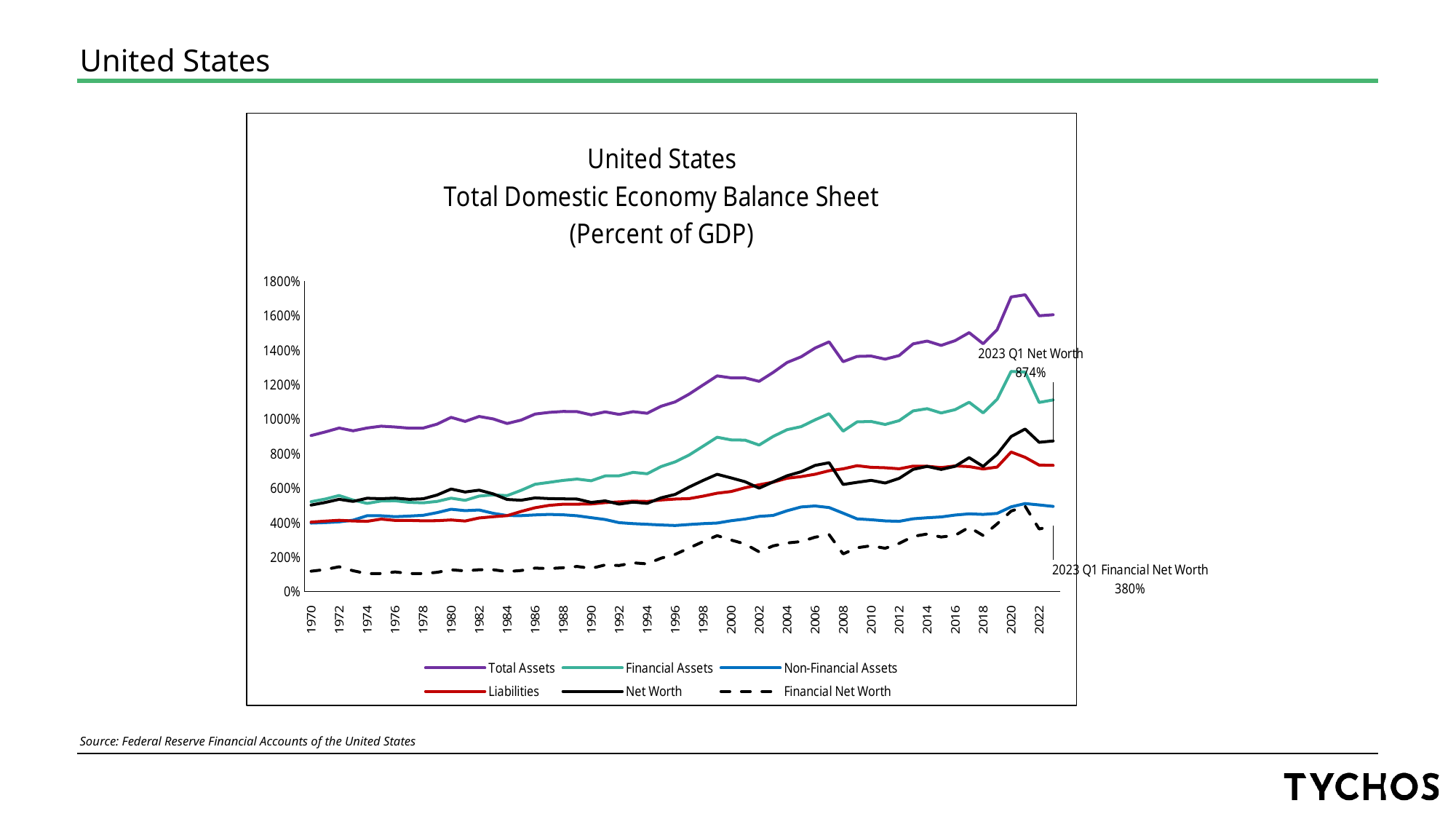
How many series does the legend list? 6 What is the 2023 Q1 Net Worth value labelled on the chart? 874% Is the value for Financial Assets in 1970 greater or less than 800%? less Does the Total Assets series generally rise or fall from 1970 to 2022? rise What kind of chart is shown on the slide? Line chart What is the 2023 Q1 Financial Net Worth value labelled on the chart? 380% What is the difference between the labelled 2023 Q1 Net Worth and 2023 Q1 Financial Net Worth values? 494% In 2022, which is larger: Liabilities or Non-Financial Assets? Liabilities Which series is drawn as a dashed line? Financial Net Worth Which series has the highest values across the whole period? Total Assets Is the value for Total Assets in 2020 greater or less than 1600%? greater Which series has the lowest values across the whole period? Financial Net Worth